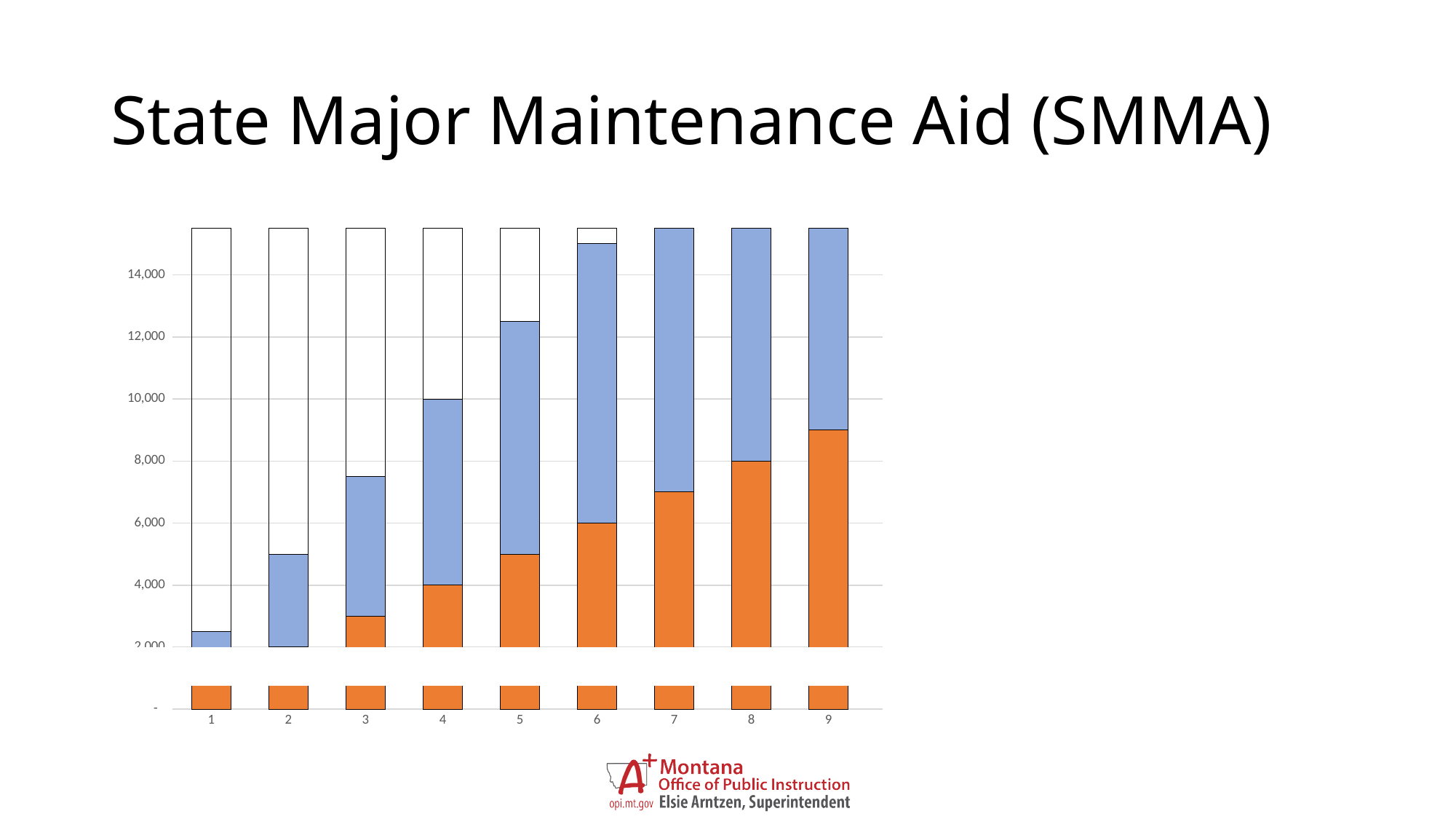
What value does the top of the orange segment reach for category 6? 6,000 Is the top of the blue segment for category 5 greater or less than 12,000? greater Do the orange segments rise or fall from category 1 to category 9? rise Is the top of the blue segment for category 1 greater or less than 4,000? less Is the top of the orange segment for category 9 greater or less than 8,000? greater What value does the top of the orange segment reach for category 8? 8,000 What value does the top of the orange segment reach for category 4? 4,000 How many categories are shown along the x axis? 9 What is the title of the slide containing the chart? State Major Maintenance Aid (SMMA) What value does the top of the blue segment reach for category 4? 10,000 Which category has the largest orange segment? 9 What kind of chart is shown on the slide? stacked bar chart